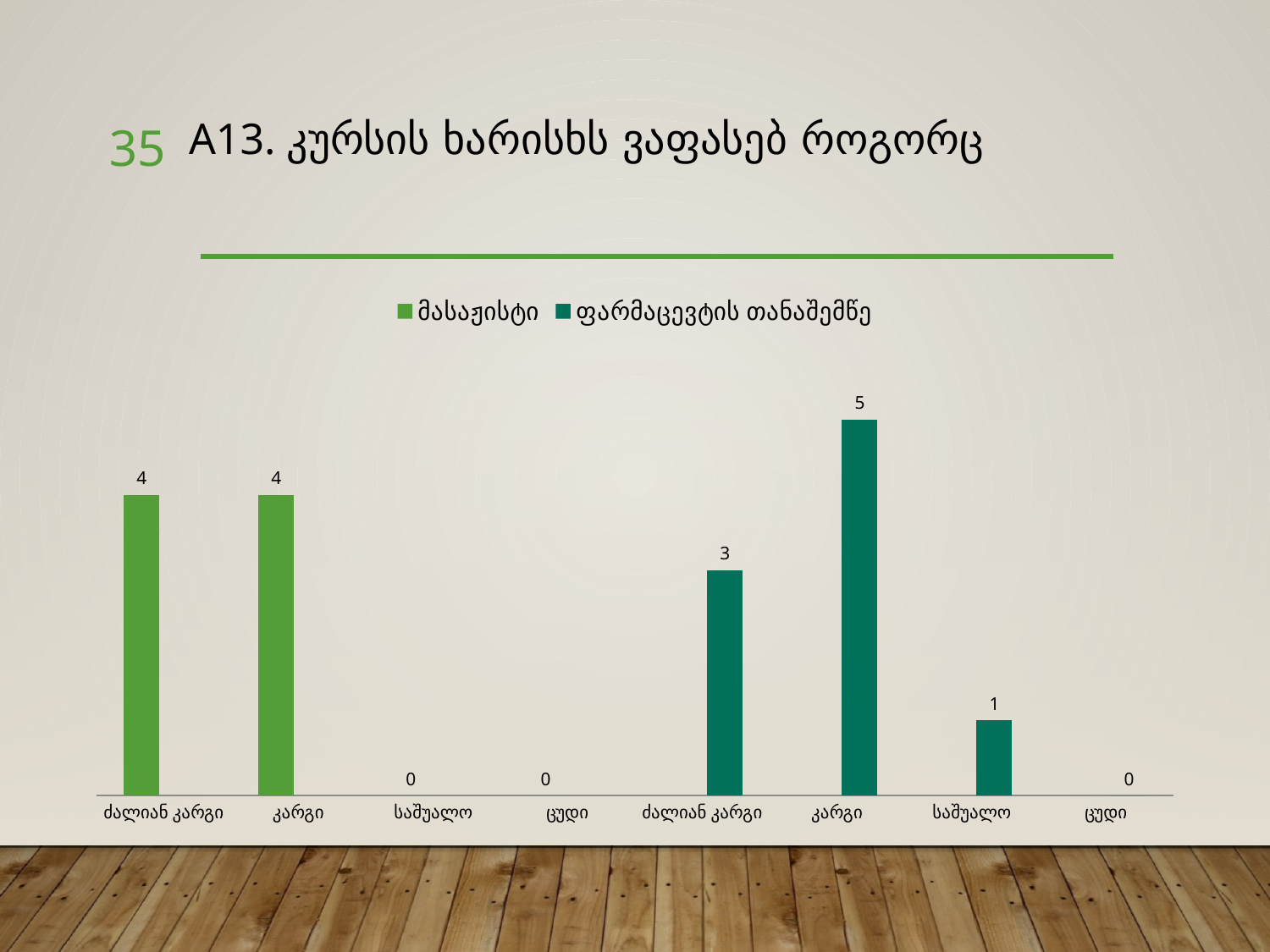
Which category has the highest value in the ფარმაცევტის თანაშემწე series? კარგი What is the value for საშუალო in the ფარმაცევტის თანაშემწე series? 1 Which is larger: ძალიან კარგი for მასაჟისტი or ძალიან კარგი for ფარმაცევტის თანაშემწე? ძალიან კარგი for მასაჟისტი What is the value for კარგი in the ფარმაცევტის თანაშემწე series? 5 What type of chart is shown on the slide? bar chart What is the value for ცუდი in the მასაჟისტი series? 0 What is the value for ძალიან კარგი in the მასაჟისტი series? 4 What is the total of all values in the ფარმაცევტის თანაშემწე series? 9 How many categories are shown on the x axis for each series? 4 What is the difference between the კარგი values of the ფარმაცევტის თანაშემწე series and the მასაჟისტი series? 1 What are the two series named in the legend? მასაჟისტი and ფარმაცევტის თანაშემწე How many series does the legend list? 2